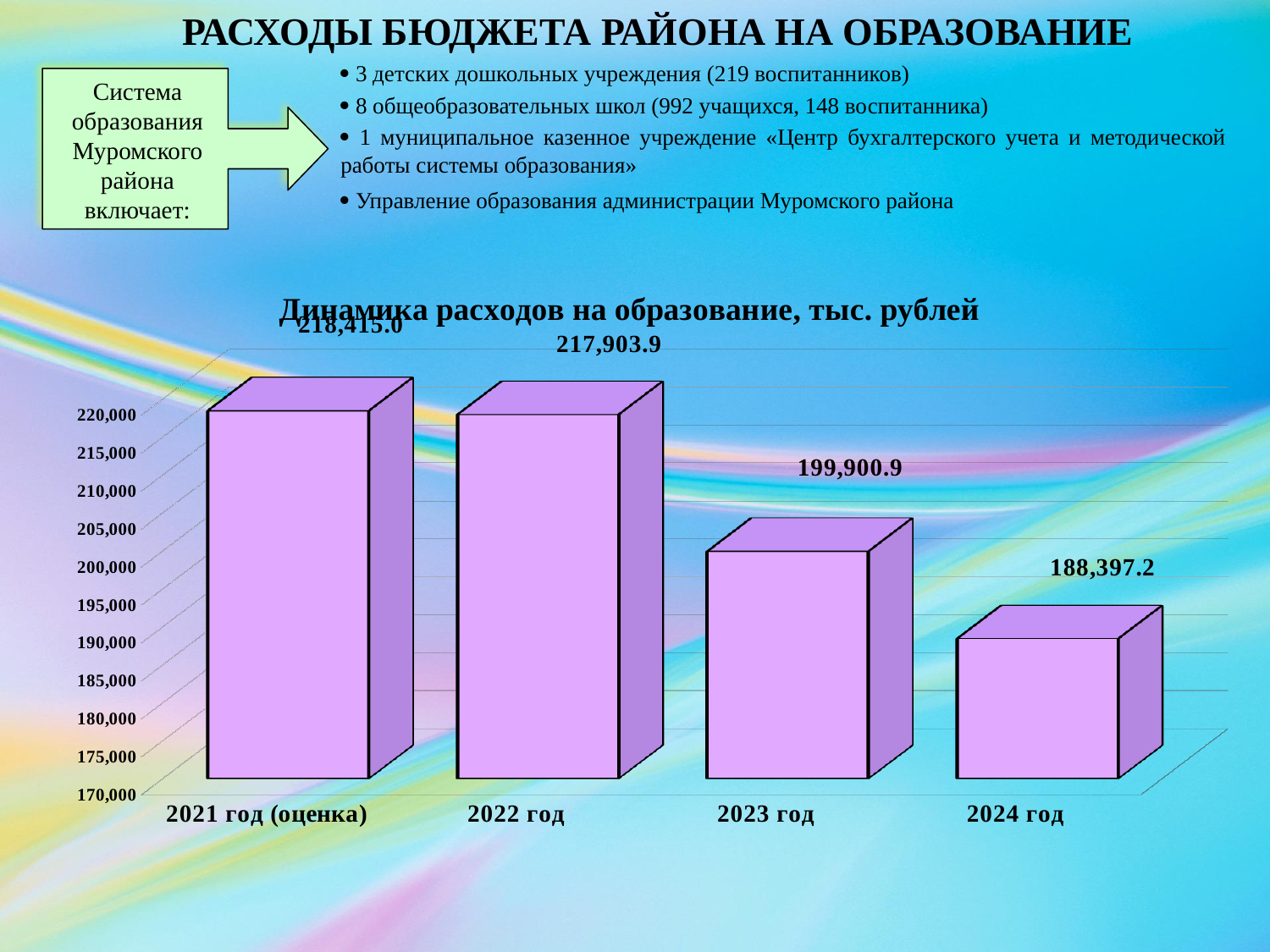
Which is larger, the value for 2022 год or the value for 2023 год? 2022 год Which year has the highest value in the chart? 2021 год (оценка) What is the difference between the values for 2022 год and 2023 год? 18,003.0 How many categories (years) are shown on the x axis of the chart? 4 What is the value for 2022 год in the chart? 217,903.9 What kind of chart is shown on the slide? Bar chart Do the values rise or fall from 2021 год (оценка) to 2024 год? Fall Which year has the lowest value in the chart? 2024 год What is the difference between the values for 2023 год and 2024 год? 11,503.7 What is the value for 2024 год in the chart? 188,397.2 What is the value for 2023 год in the chart 'Динамика расходов на образование, тыс. рублей'? 199,900.9 What is the value for 2021 год (оценка) in the chart? 218,415.0